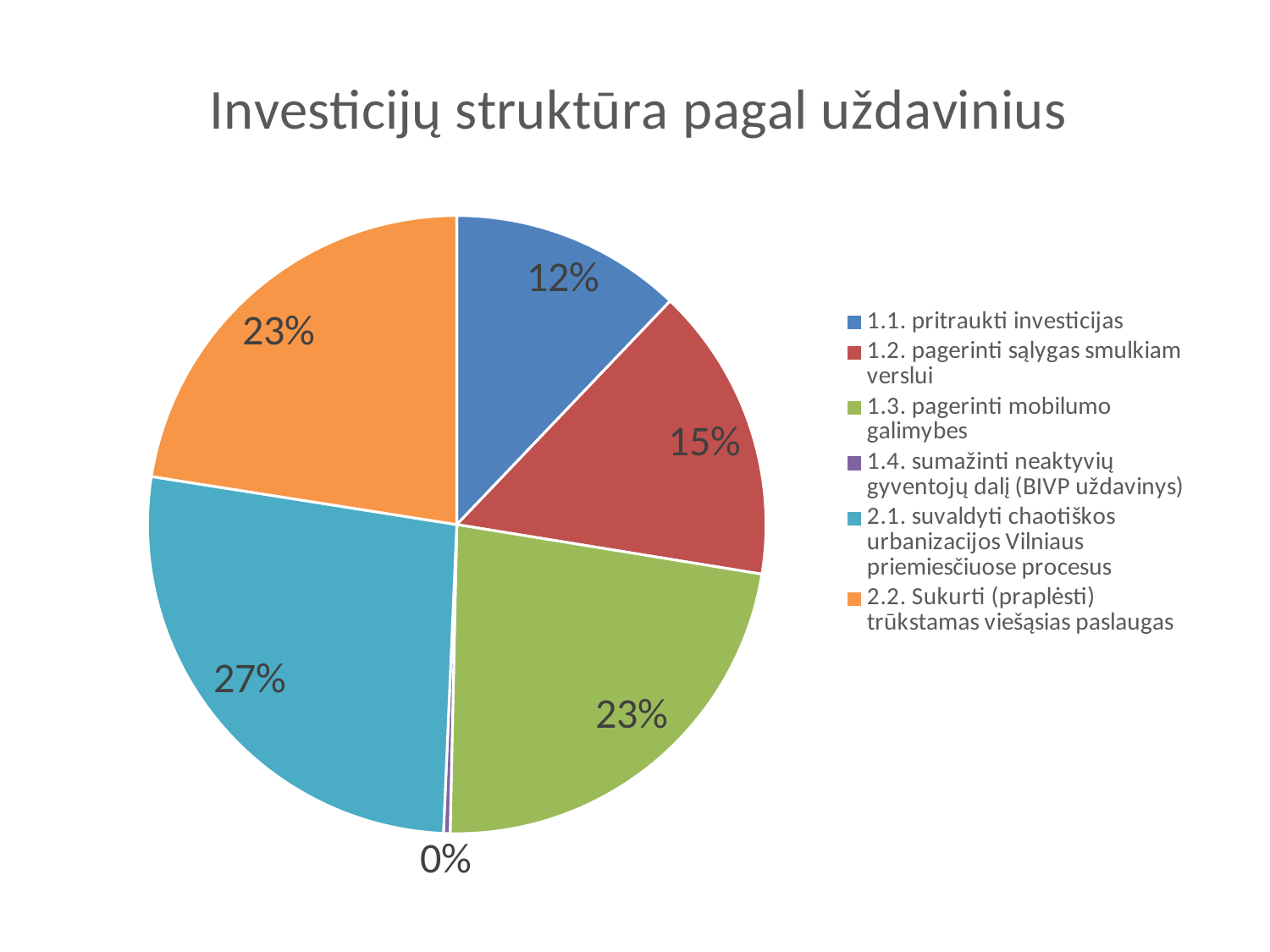
What is the difference in percentage points between the share for "2.1. suvaldyti chaotiškos urbanizacijos Vilniaus priemiesčiuose procesus" and the share for "1.1. pritraukti investicijas"? 15 percentage points Which has the larger share: "1.2. pagerinti sąlygas smulkiam verslui" or "2.2. Sukurti (praplėsti) trūkstamas viešąsias paslaugas"? 2.2. Sukurti (praplėsti) trūkstamas viešąsias paslaugas What share of the pie does "1.3. pagerinti mobilumo galimybes" have? 23% What share of the pie does "1.4. sumažinti neaktyvių gyventojų dalį (BIVP uždavinys)" have? 0% What share of the pie does "2.1. suvaldyti chaotiškos urbanizacijos Vilniaus priemiesčiuose procesus" have? 27% What is the title of the chart? Investicijų struktūra pagal uždavinius Which category has the smallest share of the pie? 1.4. sumažinti neaktyvių gyventojų dalį (BIVP uždavinys) Which category has the largest share of the pie? 2.1. suvaldyti chaotiškos urbanizacijos Vilniaus priemiesčiuose procesus What kind of chart is shown on the slide? pie chart How many categories does the legend list? 6